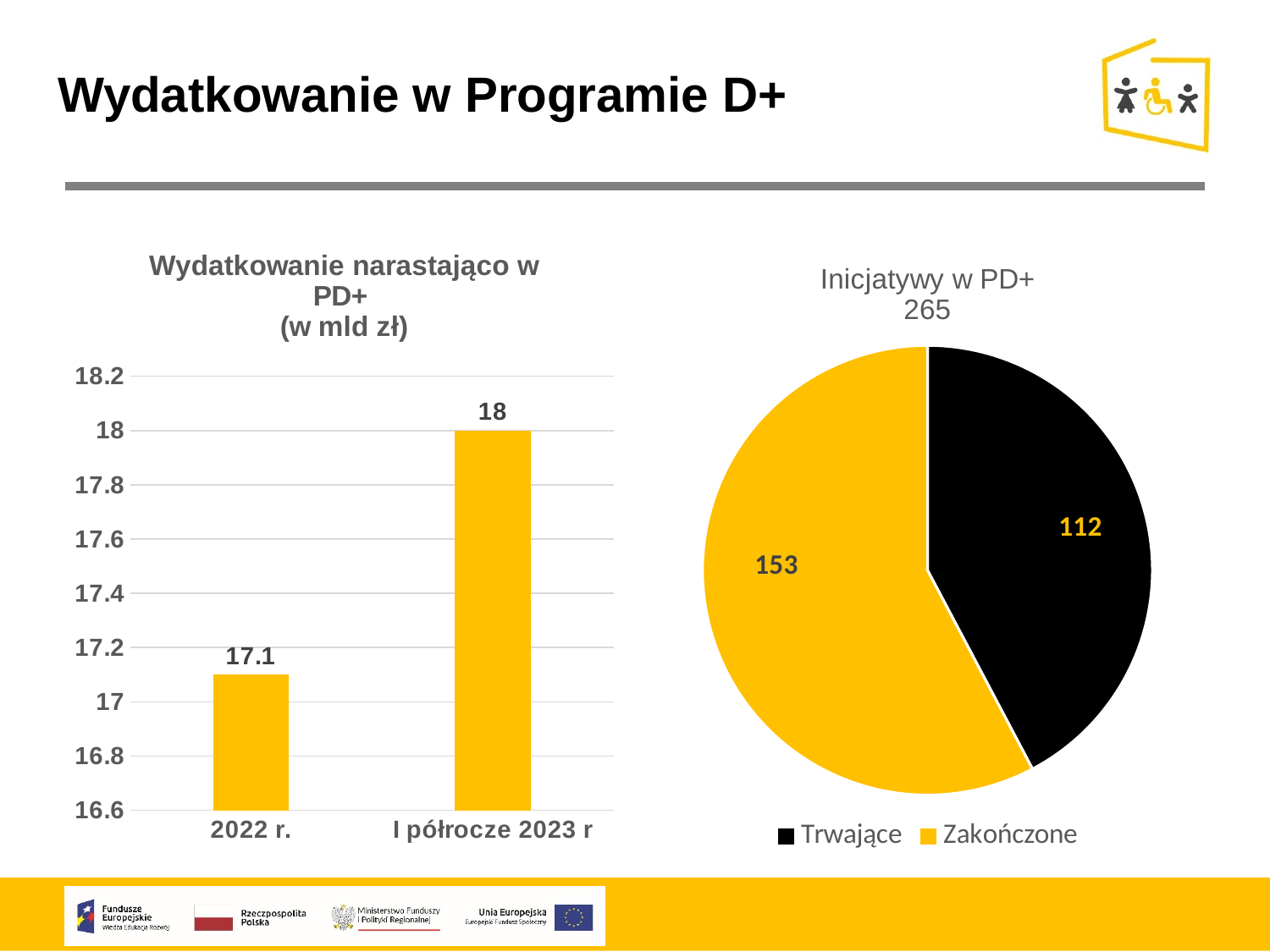
In the pie chart 'Inicjatywy w PD+', what is the difference between Zakończone and Trwające? 41 In the chart 'Wydatkowanie narastająco w PD+ (w mld zł)', how many categories are shown on the x axis? 2 In the chart 'Wydatkowanie narastająco w PD+ (w mld zł)', which category has the higher value? I półrocze 2023 r In the chart 'Wydatkowanie narastająco w PD+ (w mld zł)', do the values rise or fall from 2022 r. to I półrocze 2023 r? rise What kind of chart is 'Wydatkowanie narastająco w PD+ (w mld zł)'? bar chart In the pie chart 'Inicjatywy w PD+', what is the value for Trwające? 112 In the pie chart 'Inicjatywy w PD+', which colour represents Trwające? black In the chart 'Wydatkowanie narastająco w PD+ (w mld zł)', what is the value for I półrocze 2023 r? 18 In the chart 'Wydatkowanie narastająco w PD+ (w mld zł)', what is the value for 2022 r.? 17.1 In the pie chart 'Inicjatywy w PD+', what is the value for Zakończone? 153 In the pie chart 'Inicjatywy w PD+', which slice is larger, Trwające or Zakończone? Zakończone In the chart 'Wydatkowanie narastająco w PD+ (w mld zł)', what is the difference between the value for I półrocze 2023 r and the value for 2022 r.? 0.9